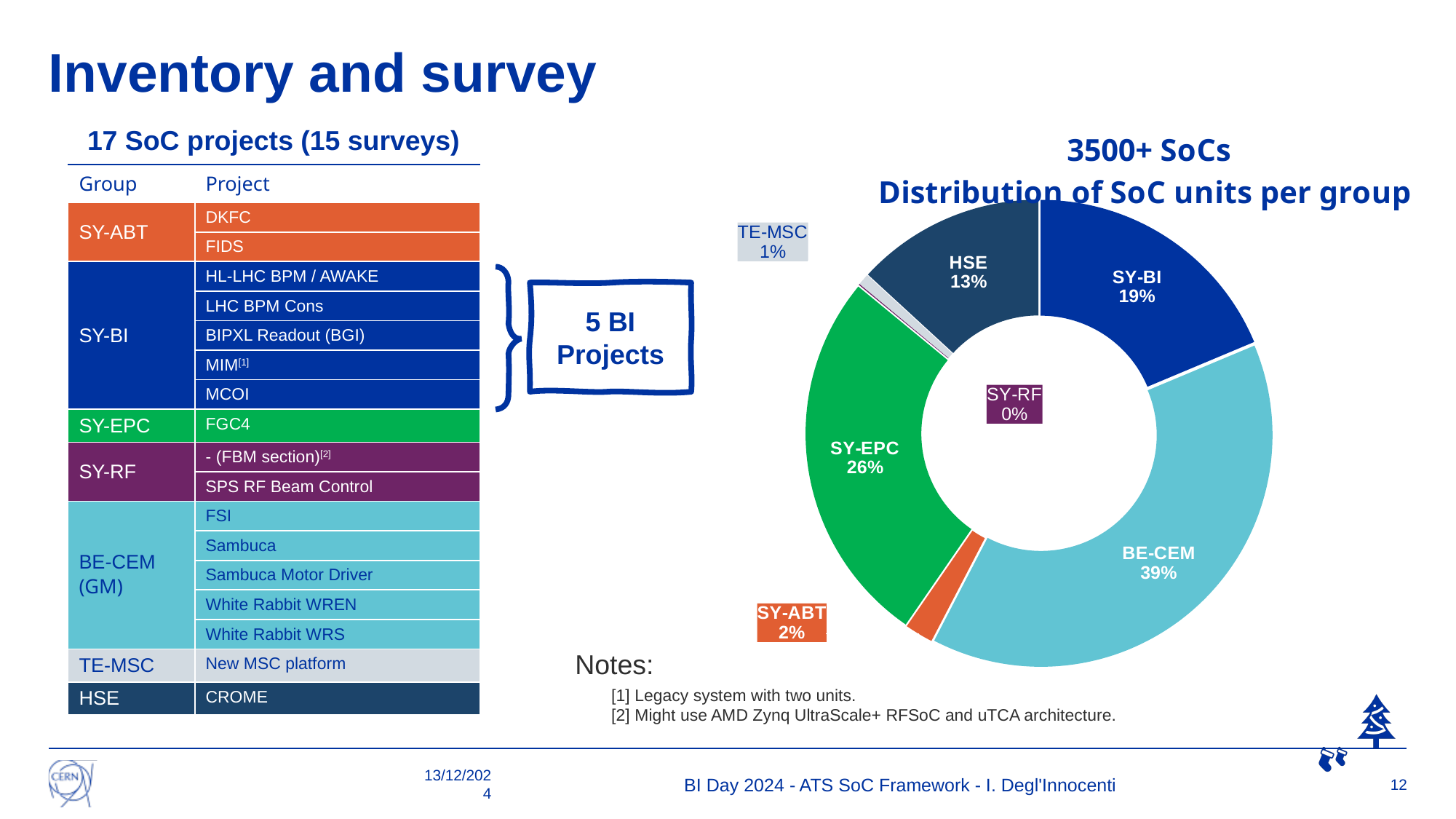
Which group has the smallest share of SoC units in the chart? SY-RF What type of chart is used to show the distribution of SoC units per group? Doughnut (pie) chart What is the title of the chart on the right side of the slide? 3500+ SoCs Distribution of SoC units per group What share of SoC units does BE-CEM account for in the Distribution of SoC units per group chart? 39% What percentage does the chart show for TE-MSC? 1% How many groups are shown in the Distribution of SoC units per group chart? 7 What percentage of SoC units is attributed to SY-EPC? 26% What is the combined share of SY-BI and HSE in the chart? 32% Which has a larger share of SoC units, SY-EPC or SY-BI? SY-EPC What is the difference in percentage points between the BE-CEM and SY-BI shares? 20 What is the share shown for HSE in the doughnut chart? 13% Which group has the largest share of SoC units in the chart? BE-CEM